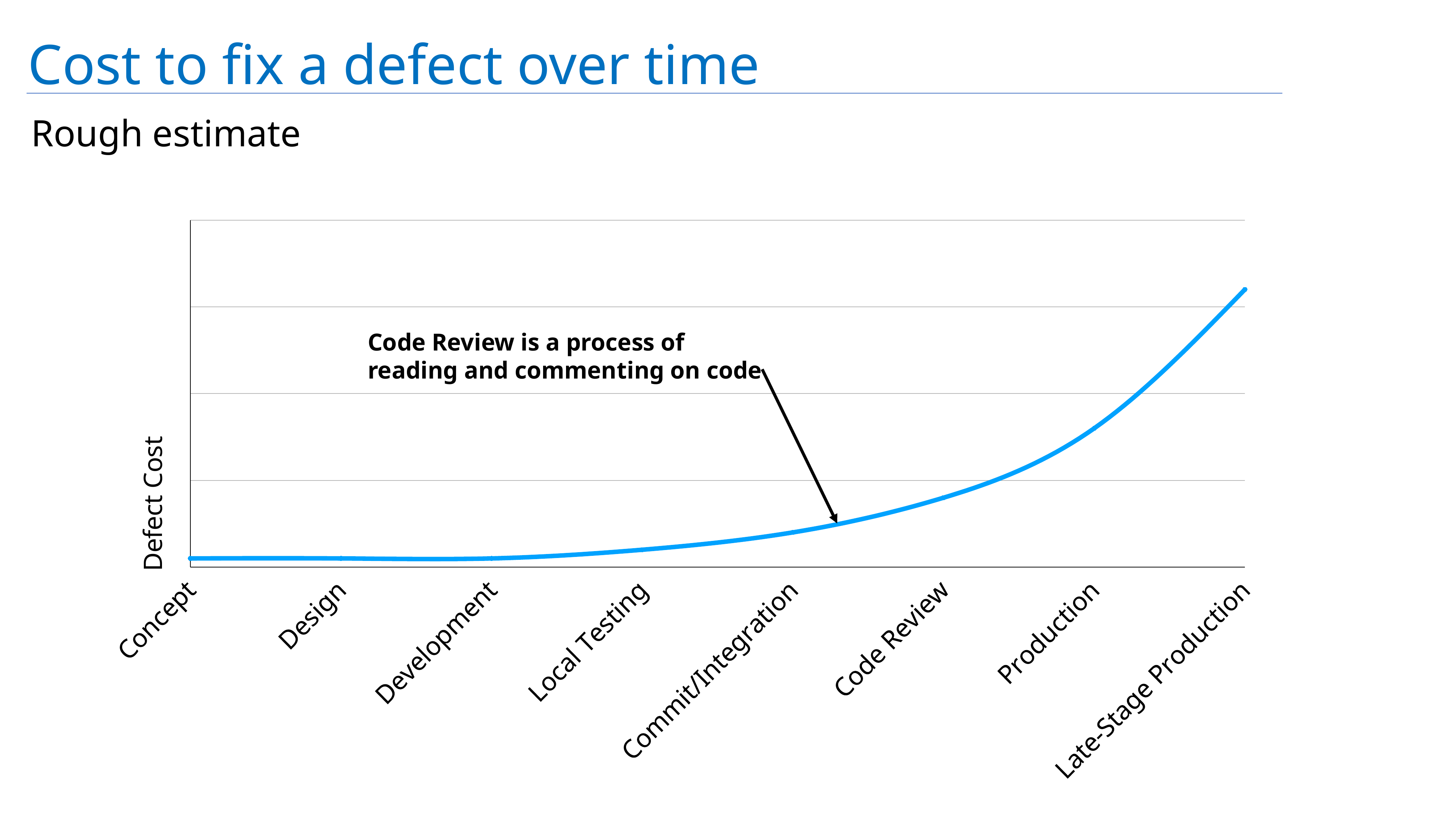
What is the label on the vertical axis of the chart? Defect Cost How many categories are shown along the x axis of the chart? 8 Which category has the highest defect cost? Late-Stage Production Which has the higher defect cost, Production or Design? Production What kind of chart is shown on the slide? Line chart Which has the higher defect cost, Code Review or Local Testing? Code Review Which has the higher defect cost, Concept or Late-Stage Production? Late-Stage Production Does the defect cost rise or fall as you move from Concept to Late-Stage Production along the x axis? Rises Which category on the x axis does the annotation arrow point to? Code Review